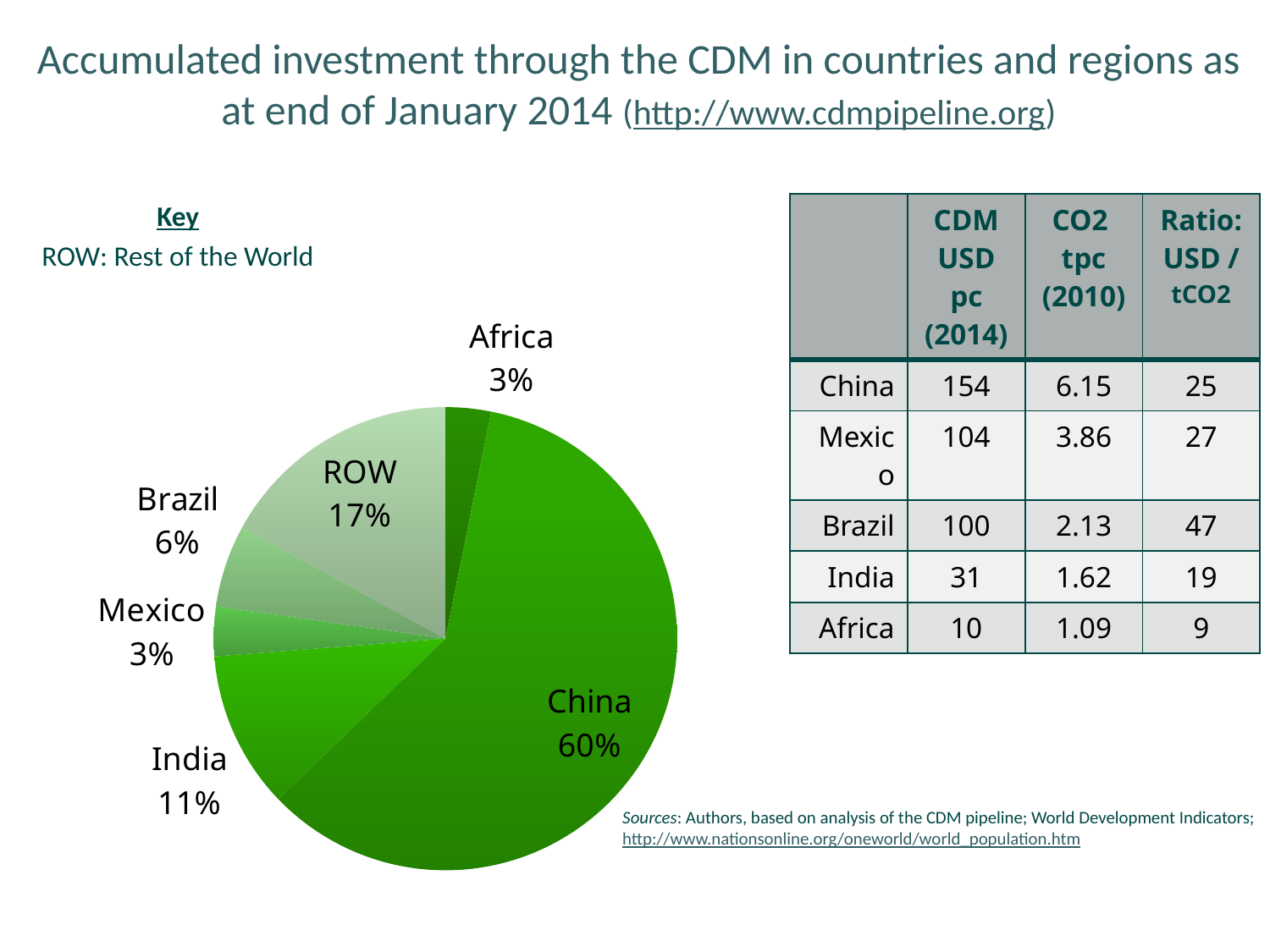
What share of the pie chart does India have? 11% Which slice is larger in the pie chart, ROW or India? ROW How many slices does the pie chart have? 6 What share of the pie chart does Brazil account for? 6% What is the difference in percentage points between the China slice and the ROW slice? 43 What is the combined share of Mexico and Africa in the pie chart? 6% What does ROW stand for according to the key on the slide? Rest of the World What share of the pie chart does China account for? 60% What percentage of the pie chart is labelled ROW? 17% Which category has the largest slice of the pie chart? China What kind of chart is shown on the slide? Pie chart Which slice is larger in the pie chart, Brazil or India? India